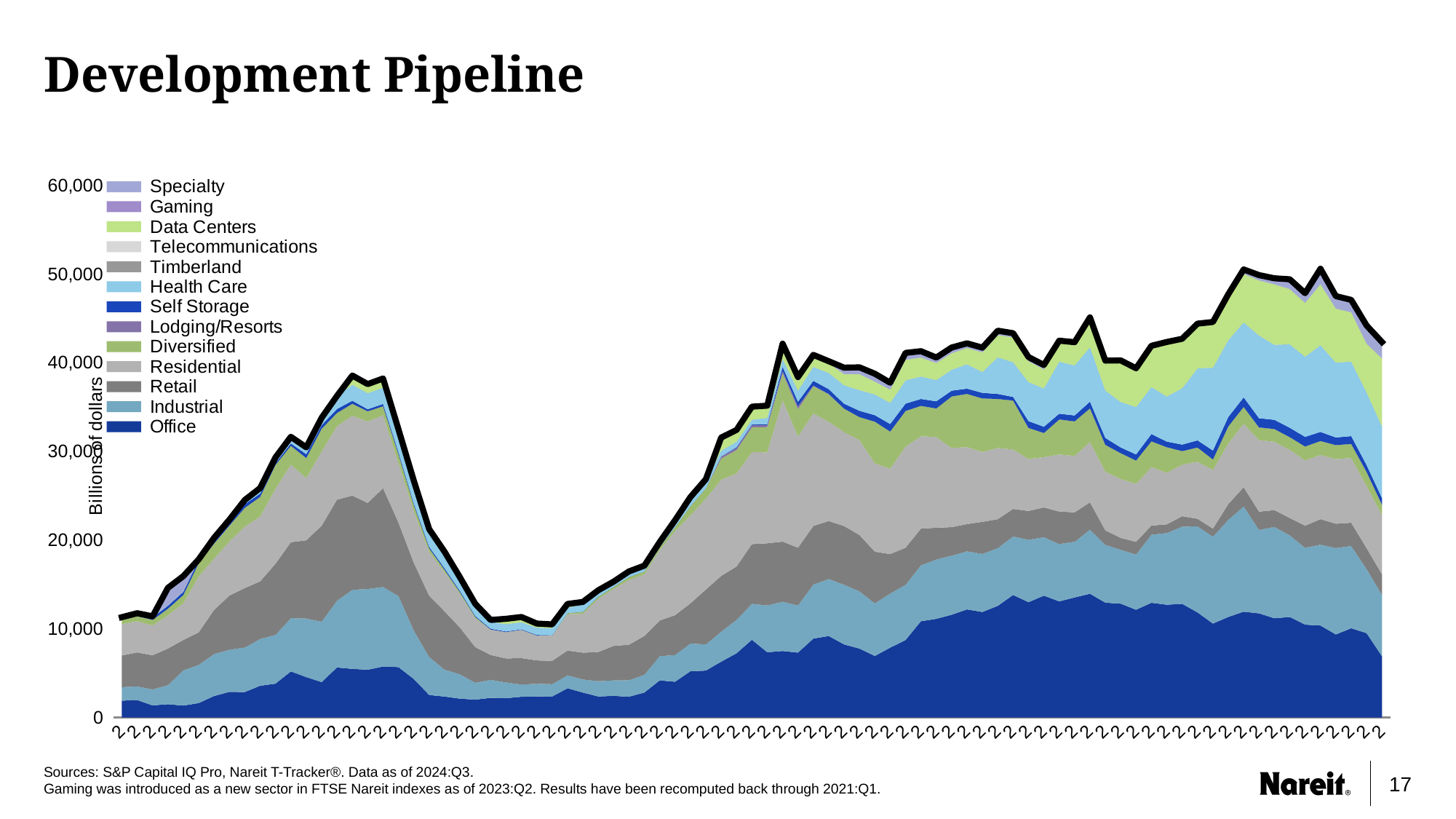
Is the highest point of the total (black line) greater or less than 40,000? greater What is the title of the slide's chart? Development Pipeline What kind of chart is shown on the slide? stacked area chart Is the total at the far left end of the chart greater or less than 20,000? less How many series does the legend list? 13 Is the total at the right end of the chart higher or lower than at the left end? higher Is the lowest point of the total (black line) greater or less than 20,000? less Which series is plotted at the bottom of the stacked area chart? Office